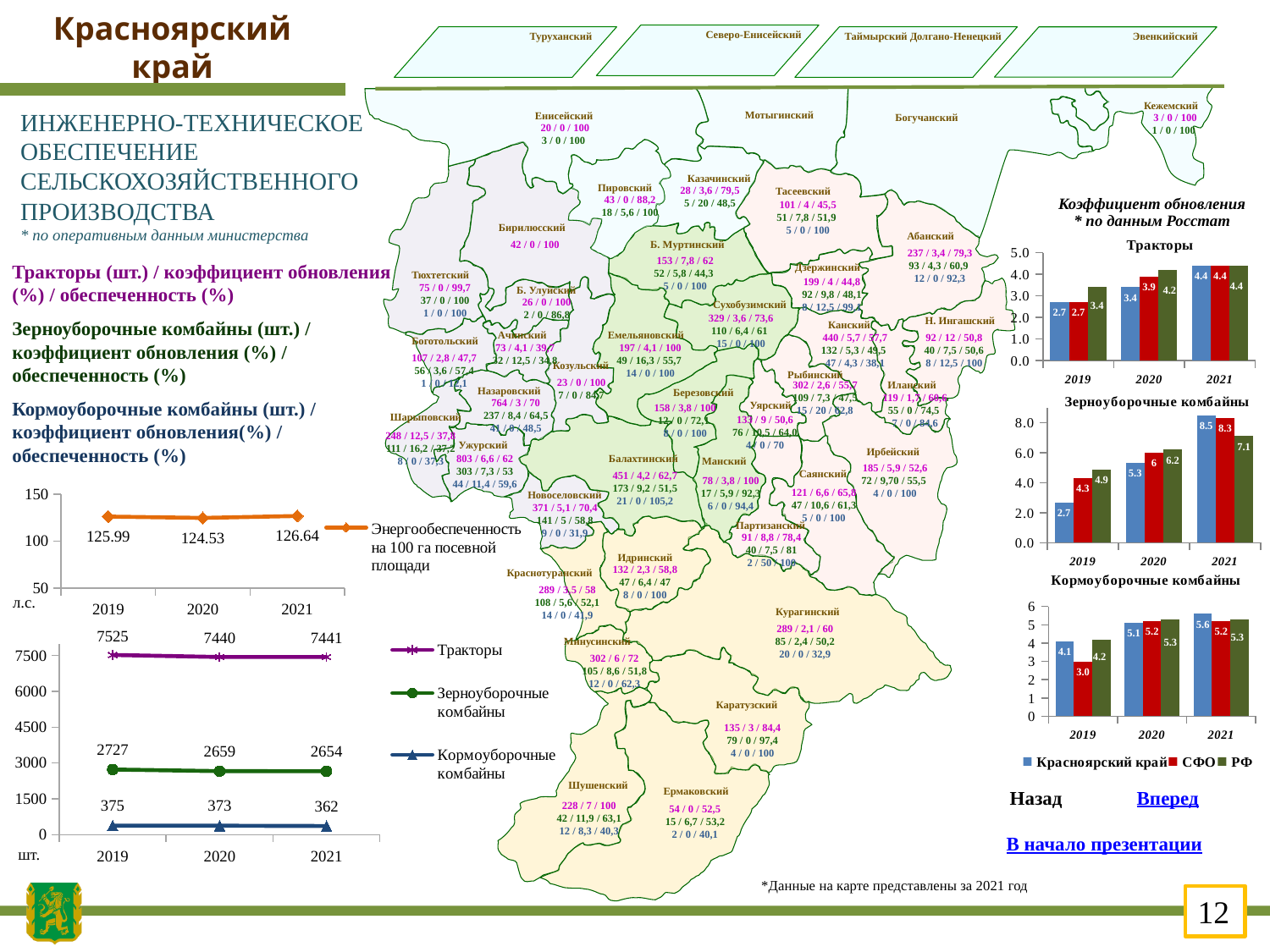
In the lower-left line chart (шт.), what is the difference between the Зерноуборочные комбайны values for 2019 and 2021? 73 In the bar chart 'Кормоуборочные комбайны' under 'Коэффициент обновления', what is the value for СФО in 2019? 3.0 In the bar chart 'Тракторы' under 'Коэффициент обновления', what is the value for Красноярский край in 2020? 3.4 In the lower-left line chart (шт.), what is the value for Тракторы in 2019? 7525 In the line chart 'Энергообеспеченность на 100 га посевной площади' on the left, what is the value for 2021? 126.64 In the bar chart 'Зерноуборочные комбайны' under 'Коэффициент обновления', which series has the lowest value in 2021? РФ What type of chart is the 'Тракторы' chart under 'Коэффициент обновления'? bar chart How many series does the legend of the lower-left line chart (шт.) list? 3 In the lower-left line chart (шт.), what is the value for Кормоуборочные комбайны in 2021? 362 In the bar chart 'Кормоуборочные комбайны' under 'Коэффициент обновления', is the value for Красноярский край in 2021 larger or smaller than the value for СФО in 2021? larger In the bar chart 'Зерноуборочные комбайны' under 'Коэффициент обновления', what is the value for Красноярский край in 2021? 8.5 In the line chart 'Энергообеспеченность на 100 га посевной площади' on the left, which year has the lowest value? 2020